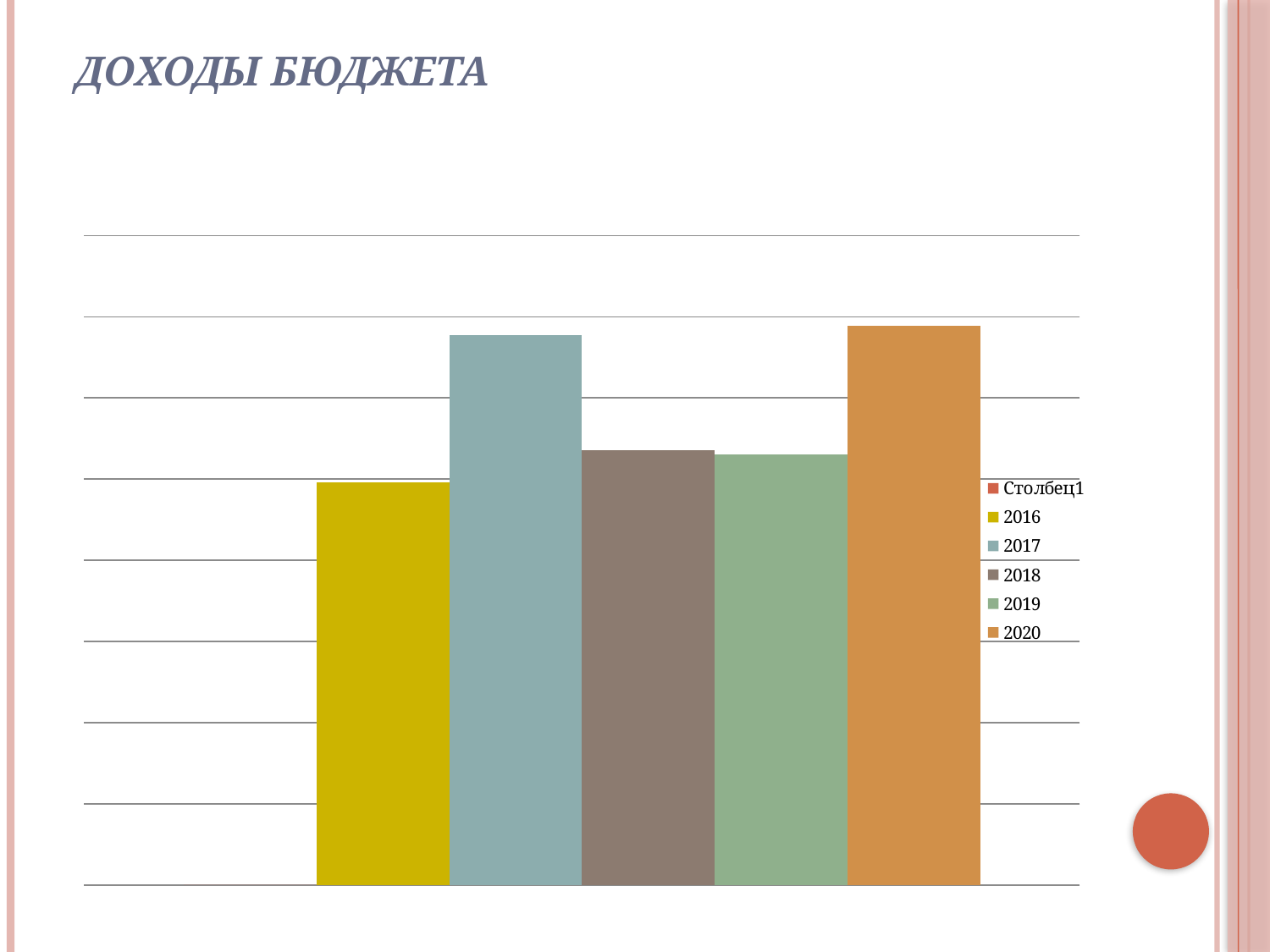
Which is larger, the bar for 2019 or the bar for 2016? 2019 Which legend entry is listed first in the chart's legend? Столбец1 How many bars are plotted in the chart? 5 What is the title of the slide with the chart? ДОХОДЫ БЮДЖЕТА What kind of chart is shown on the slide? bar chart Which is larger, the bar for 2020 or the bar for 2018? 2020 Which year has the lowest bar in the chart? 2016 Which is larger, the bar for 2017 or the bar for 2016? 2017 What colour is the bar for 2020 in the chart? orange How many entries does the chart's legend list? 6